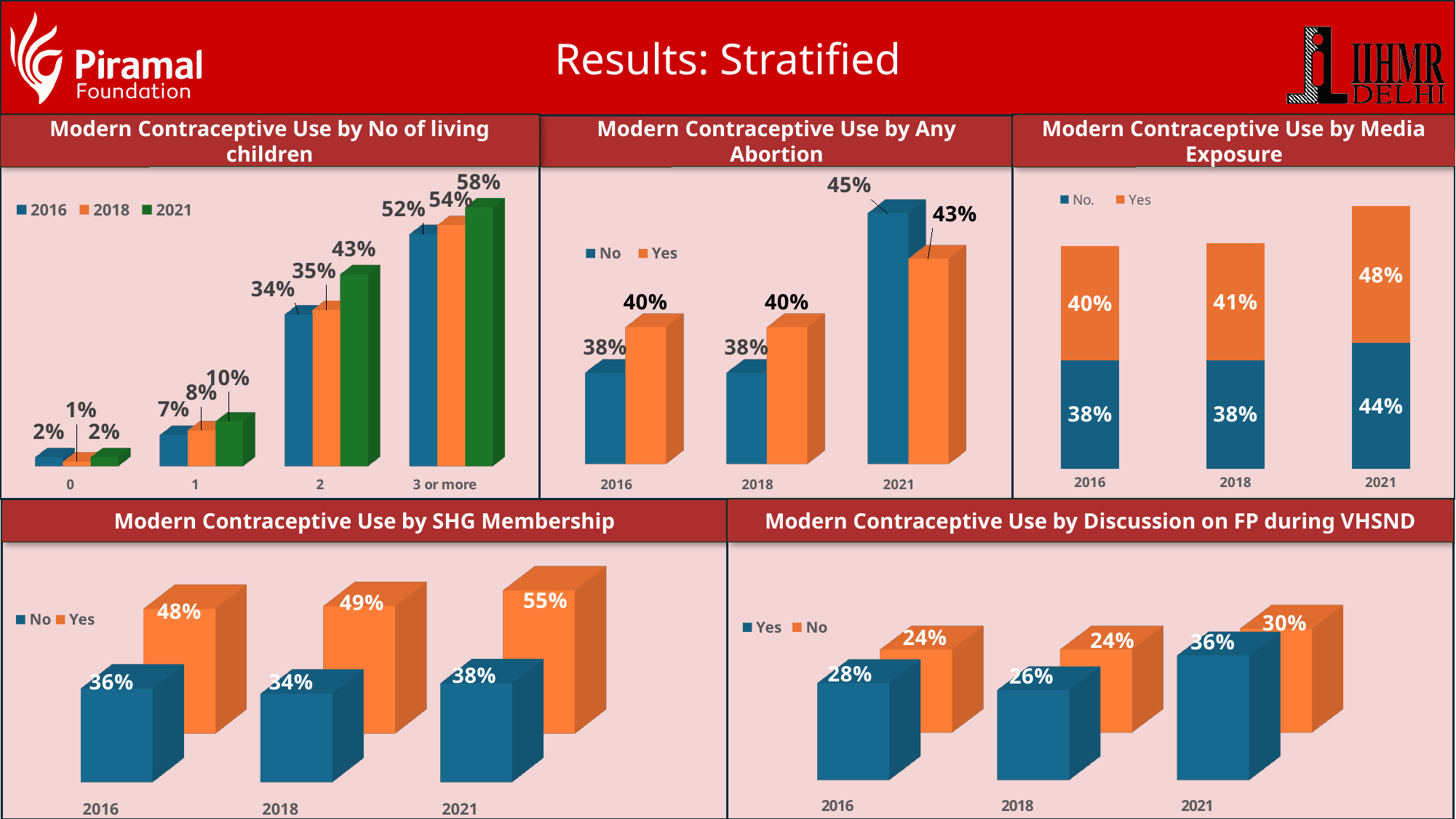
In the 'Modern Contraceptive Use by SHG Membership' chart, what is the 'Yes' value for 2018? 49% In the 'Modern Contraceptive Use by No of living children' chart, how many series does the legend list? 3 In the 'Modern Contraceptive Use by Discussion on FP during VHSND' chart, how do the 'Yes' values change from 2018 to 2021? They rise In the 'Modern Contraceptive Use by No of living children' chart, what is the 2021 value for women with 3 or more living children? 58% In the 'Modern Contraceptive Use by No of living children' chart, what is the difference between the 2021 and 2016 values for women with 2 living children? 9% In the 'Modern Contraceptive Use by No of living children' chart, which category has the lowest 2018 value? 0 In the 'Modern Contraceptive Use by Media Exposure' chart, what is the 'Yes' value for 2021? 48% In the 'Modern Contraceptive Use by SHG Membership' chart, what is the difference between 'Yes' and 'No' in 2021? 17% In the 'Modern Contraceptive Use by Any Abortion' chart, which is larger in 2016, 'No' or 'Yes'? Yes What kind of chart is 'Modern Contraceptive Use by Media Exposure'? Stacked bar chart In the 'Modern Contraceptive Use by Any Abortion' chart, what is the value for 'No' in 2021? 45% In the 'Modern Contraceptive Use by Media Exposure' chart, what is the total of the stacked bar for 2018? 79%